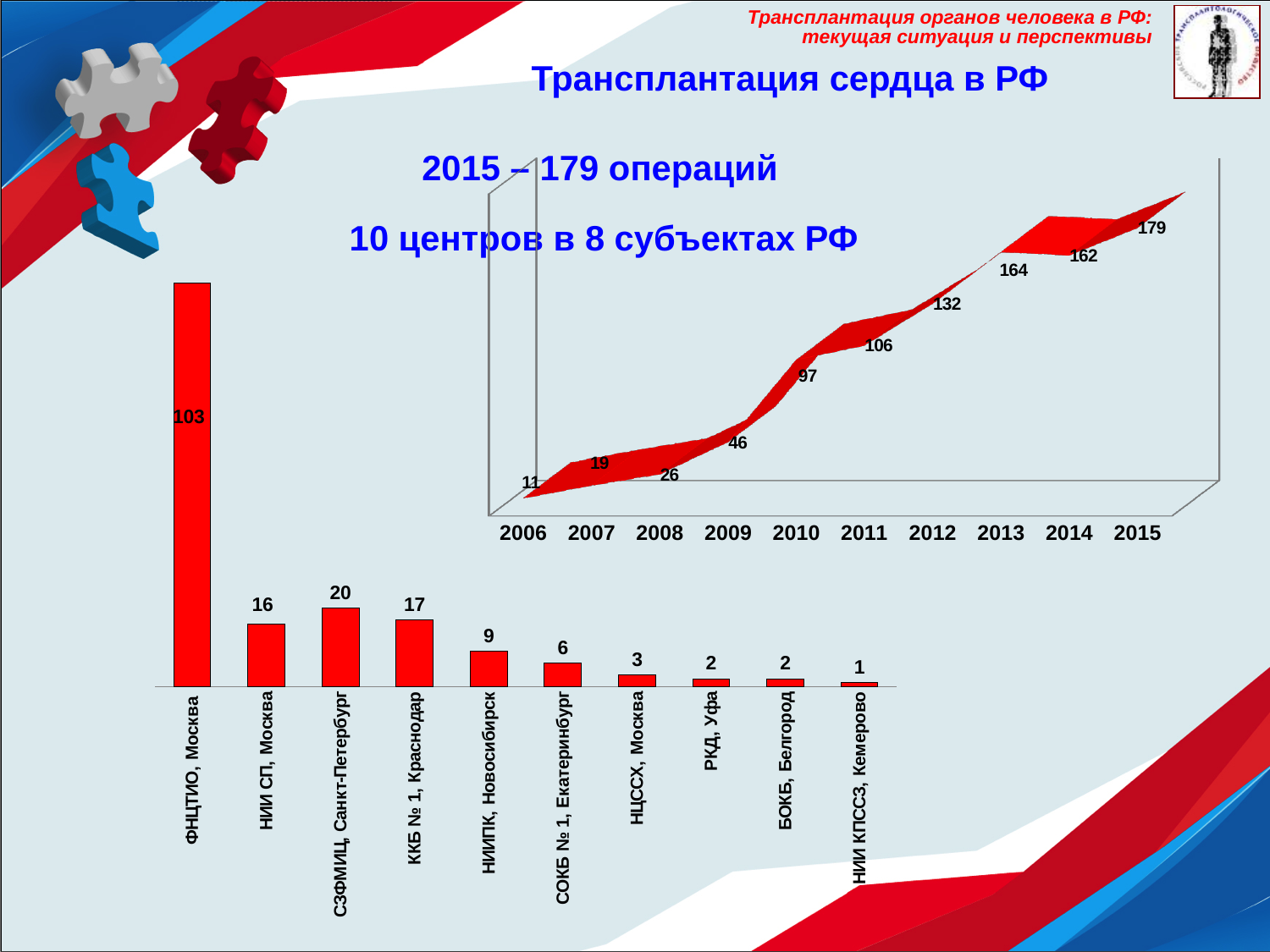
In the chart at the top right, do the values generally rise or fall from 2006 to 2015? rise In the chart at the top right, what is the value for 2015? 179 In the chart at the top right, what is the difference between 2013 and 2014? 2 How many centers are shown in the bar chart at the bottom left? 10 In the bar chart at the bottom left, what is the value for СЗФМИЦ, Санкт-Петербург? 20 In the bar chart at the bottom left, which center has the lowest value? НИИ КПССЗ, Кемерово In the bar chart at the bottom left, which is larger: ККБ № 1, Краснодар or НИИПК, Новосибирск? ККБ № 1, Краснодар In the chart at the top right, what is the value for 2010? 97 How many years are shown on the x axis of the chart at the top right? 10 In the bar chart at the bottom left, which center has the highest value? ФНЦТИО, Москва In the bar chart at the bottom left, what is the value for ФНЦТИО, Москва? 103 In the bar chart at the bottom left, what is the difference between ФНЦТИО, Москва and НИИ СП, Москва? 87